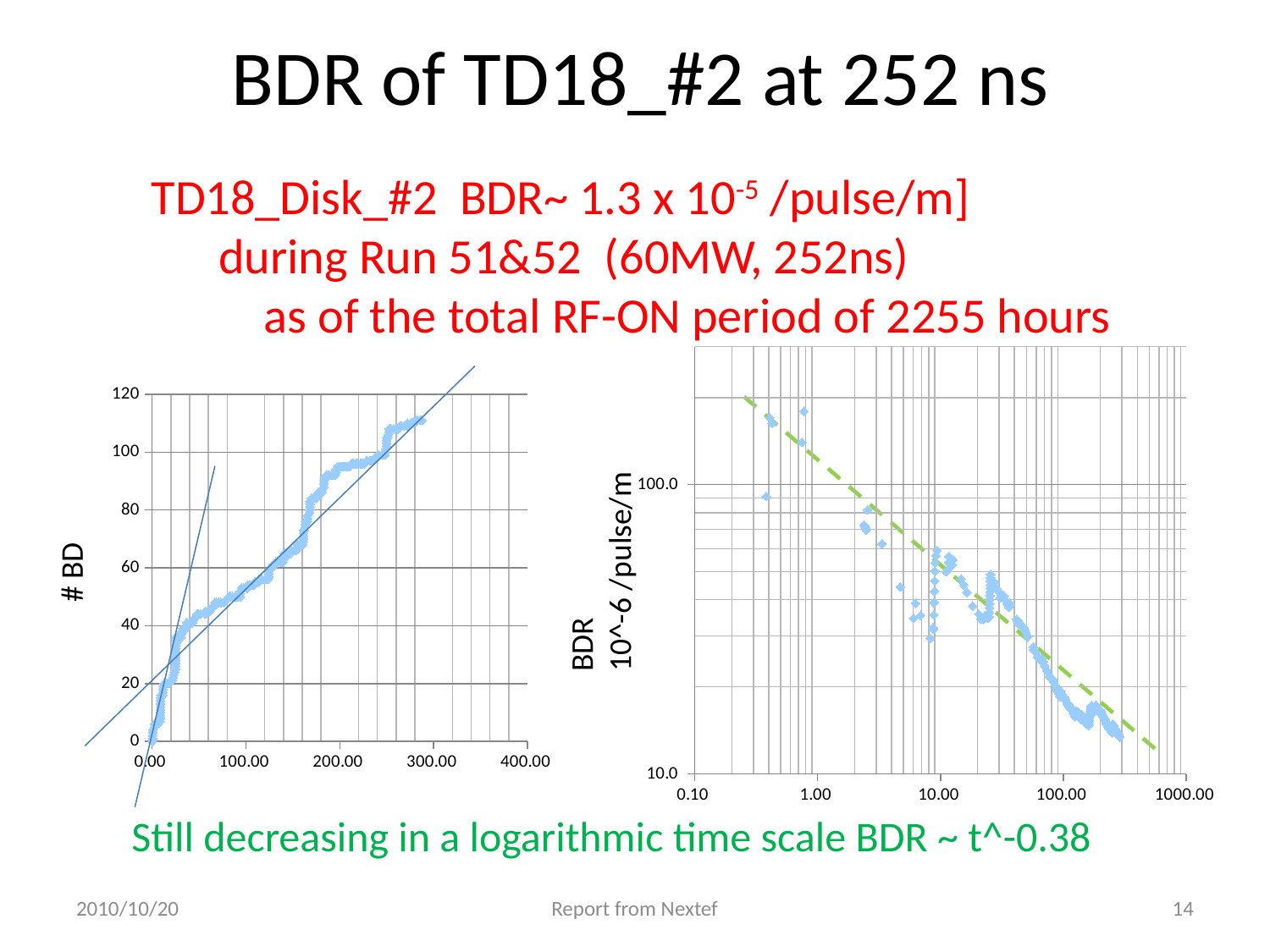
In the left chart, what is the highest tick value shown on the vertical axis? 120 In the left chart, do the plotted values rise or fall as you move along the x axis? rise What kind of chart is the right chart on the slide? scatter chart In the right chart, what is the largest tick value shown on the horizontal axis? 1000.00 In the left chart, what is the label on the vertical axis? # BD In the right chart, is the BDR value at x = 100.00 greater or less than 100.0? less In the left chart, is the value of # BD at x = 100.00 greater or less than 60? less What kind of chart is the left chart on the slide? scatter chart In the right chart, do the plotted values rise or fall as you move along the x axis? fall In the left chart, is the value of # BD at x = 300.00 greater or less than 100? greater In the right chart, what is the label on the vertical axis? BDR 10^-6 /pulse/m